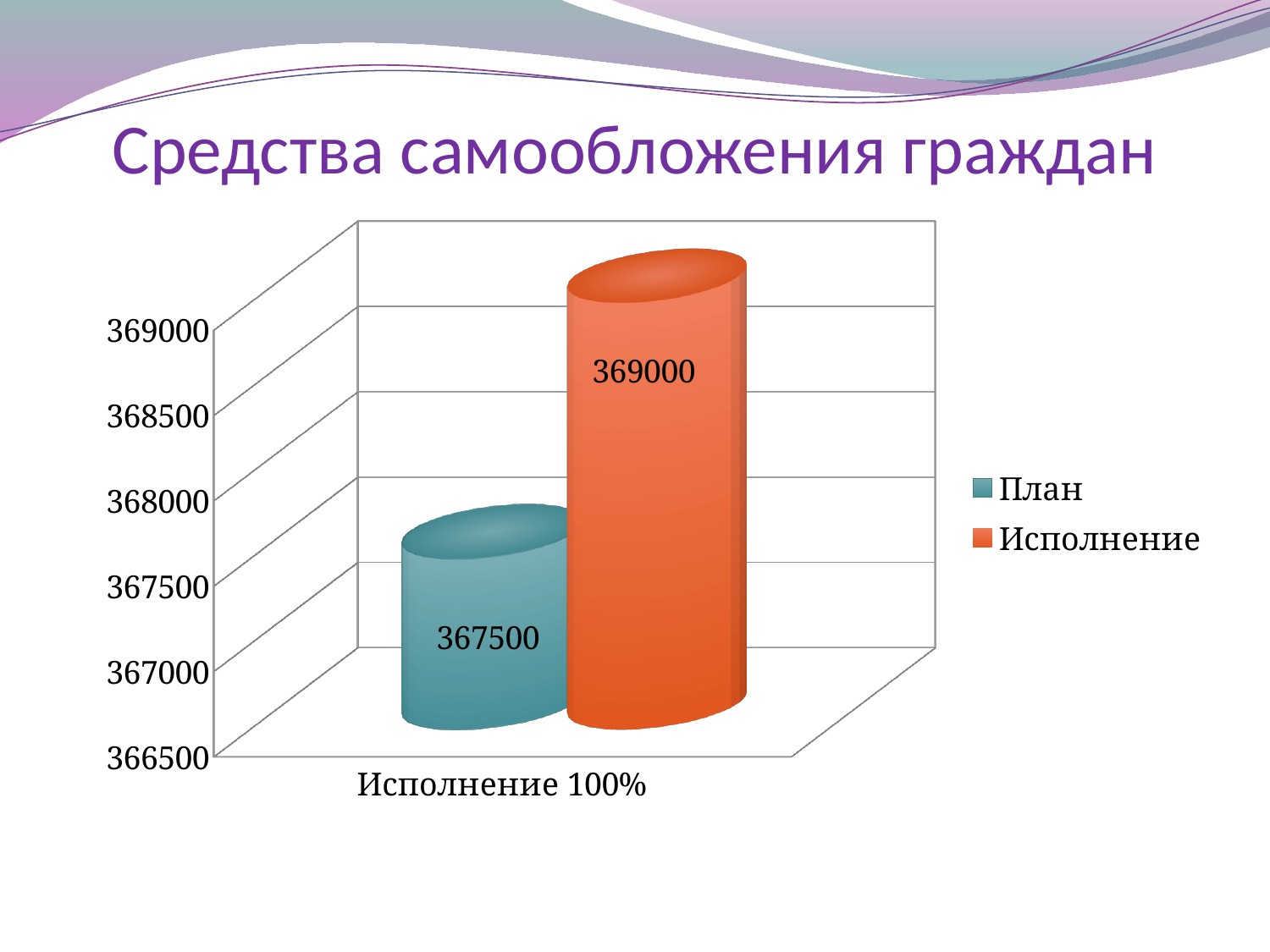
Which series has the lowest value? План What kind of chart is shown on the slide? Bar chart Is the value for План greater or less than 368000? less How many series does the legend list? 2 What is the difference between the Исполнение value and the План value? 1500 How many categories are shown on the x axis? 1 What is the value for План? 367500 What is the title of the slide? Средства самообложения граждан Which series has the highest value? Исполнение What is the value for Исполнение? 369000 Which series has the higher value, План or Исполнение? Исполнение Is the value for Исполнение greater or less than 368500? greater